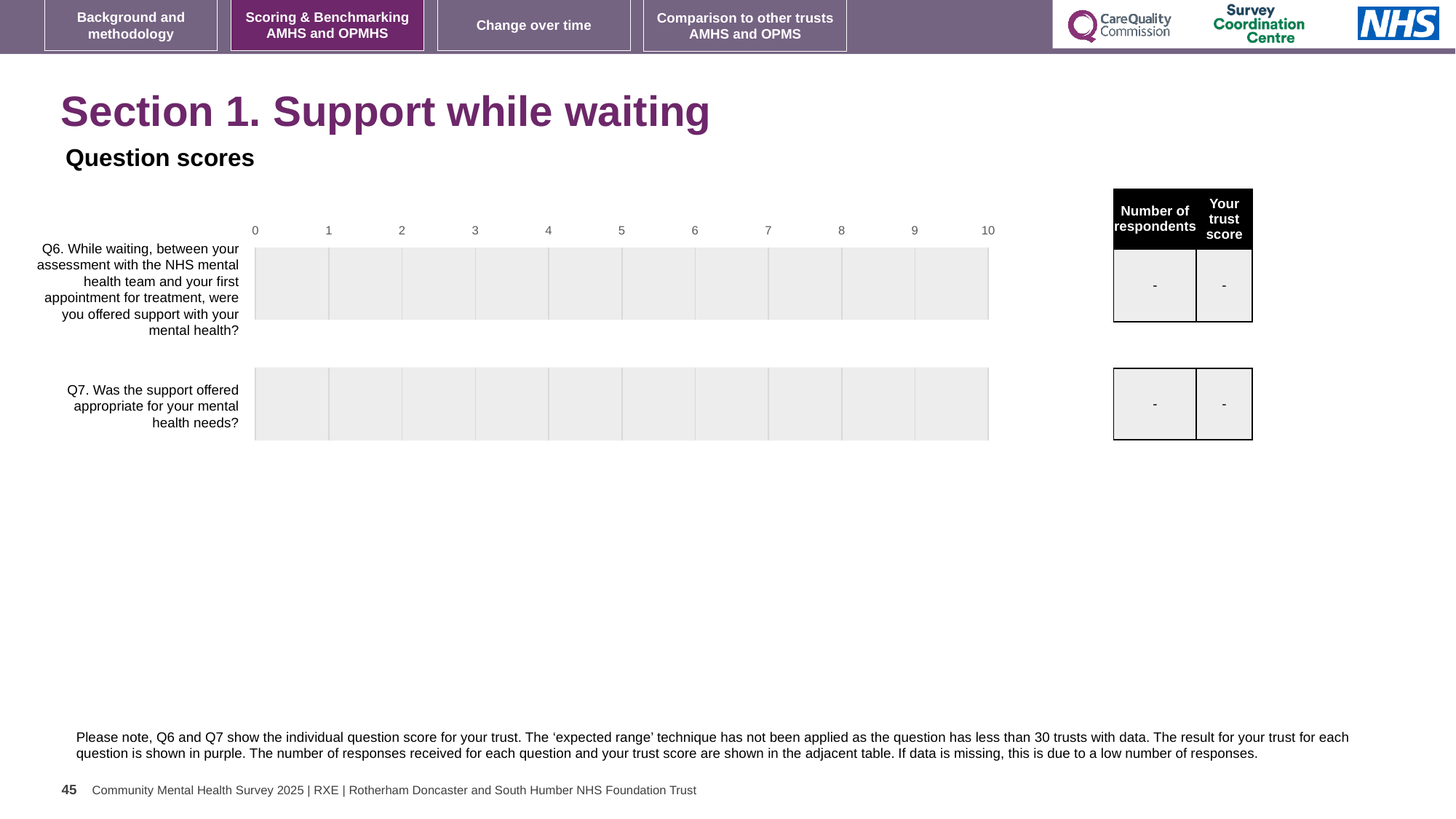
What kind of chart is shown on the slide? bar chart How many questions (categories) are listed on the chart? 2 What is the 'Number of respondents' shown in the table for Q7? - What is the highest value shown on the chart's axis? 10 What is the 'Your trust score' shown in the table for Q6? - What is the lowest value shown on the chart's axis? 0